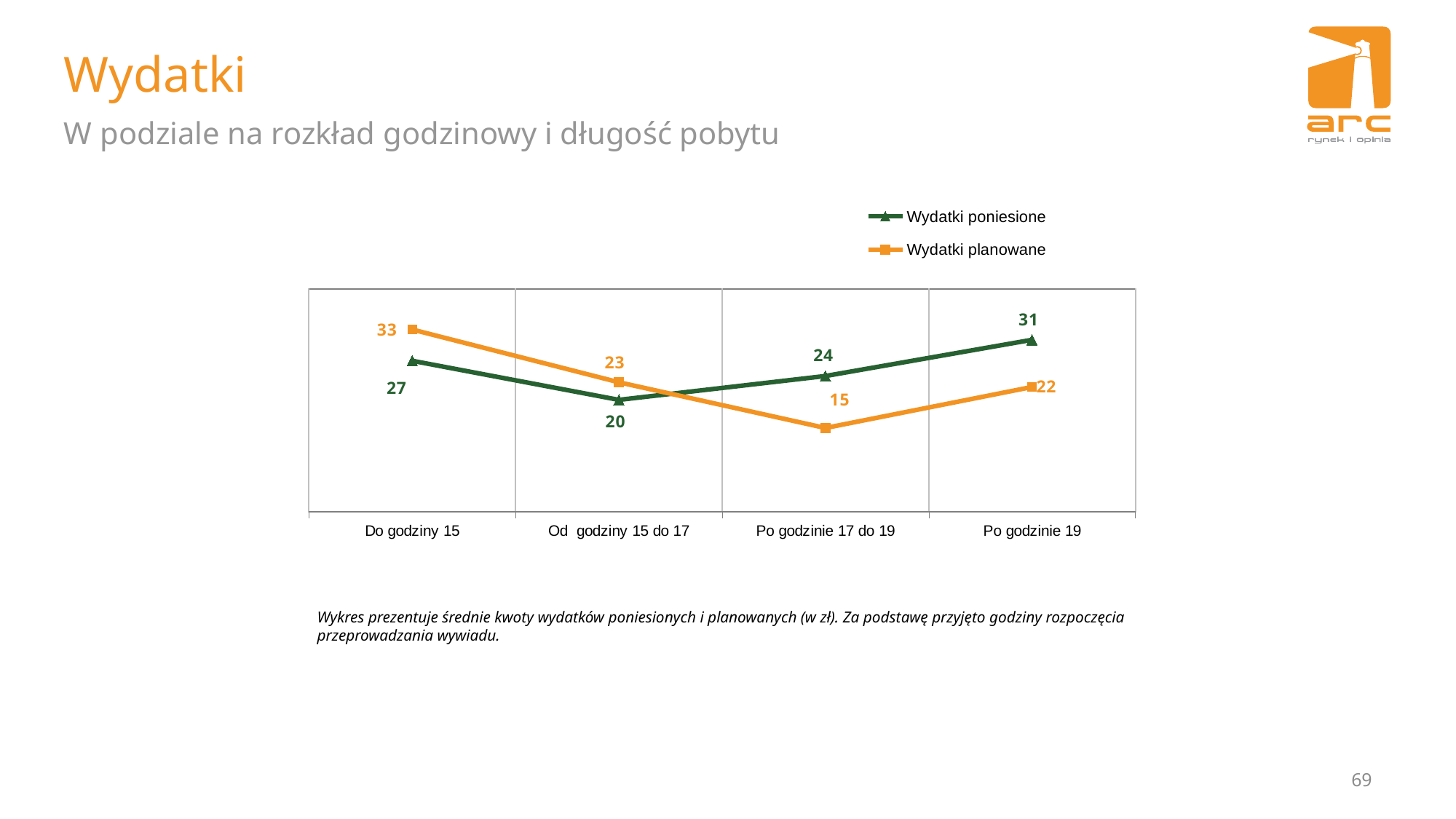
What is the value of Wydatki planowane for Po godzinie 17 do 19? 15 What is the value of Wydatki poniesione for Po godzinie 19? 31 What kind of chart is shown on the slide? Line chart What is the difference between Wydatki planowane and Wydatki poniesione for Do godziny 15? 6 How many series does the legend list? 2 What is the value of Wydatki planowane for Od godziny 15 do 17? 23 Which is larger for Od godziny 15 do 17: Wydatki poniesione or Wydatki planowane? Wydatki planowane Which category has the highest value for Wydatki poniesione? Po godzinie 19 How many categories are shown on the x axis? 4 Which category has the lowest value for Wydatki planowane? Po godzinie 17 do 19 What is the value of Wydatki poniesione for Do godziny 15? 27 What is the difference between Wydatki poniesione and Wydatki planowane for Po godzinie 19? 9